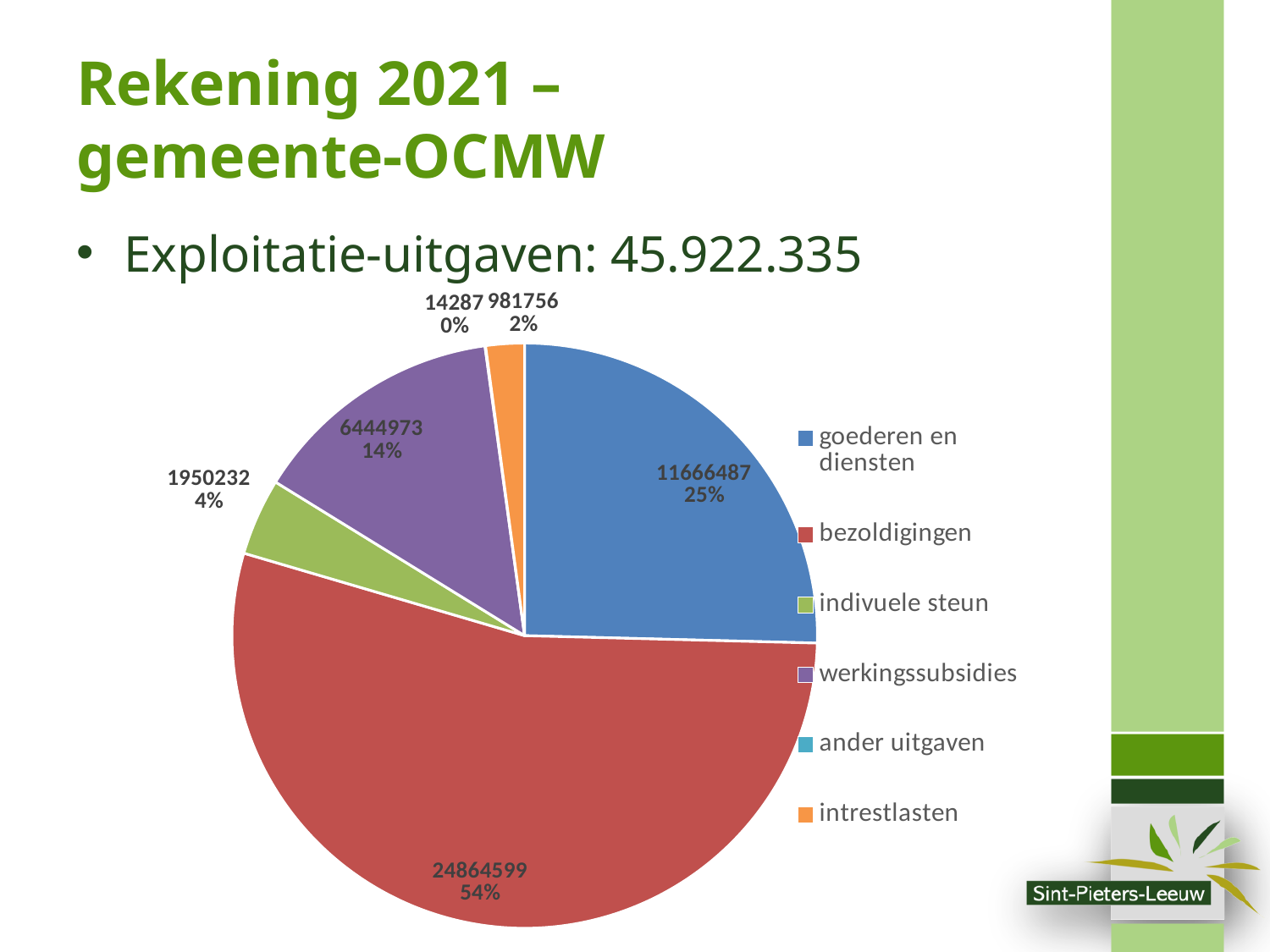
What is the value for goederen en diensten? 11666487 What is the value for werkingssubsidies? 6444973 What is the value for bezoldigingen? 24864599 How many categories does the legend list? 6 What kind of chart is shown on the slide? pie chart What percentage share of the pie does indivuele steun have? 4% What is the value for intrestlasten? 981756 Which category has the smallest slice of the pie? ander uitgaven What is the difference between the values for bezoldigingen and goederen en diensten? 13198112 Which is larger, goederen en diensten or werkingssubsidies? goederen en diensten Which category has the largest slice of the pie? bezoldigingen What percentage share of the pie does bezoldigingen have? 54%